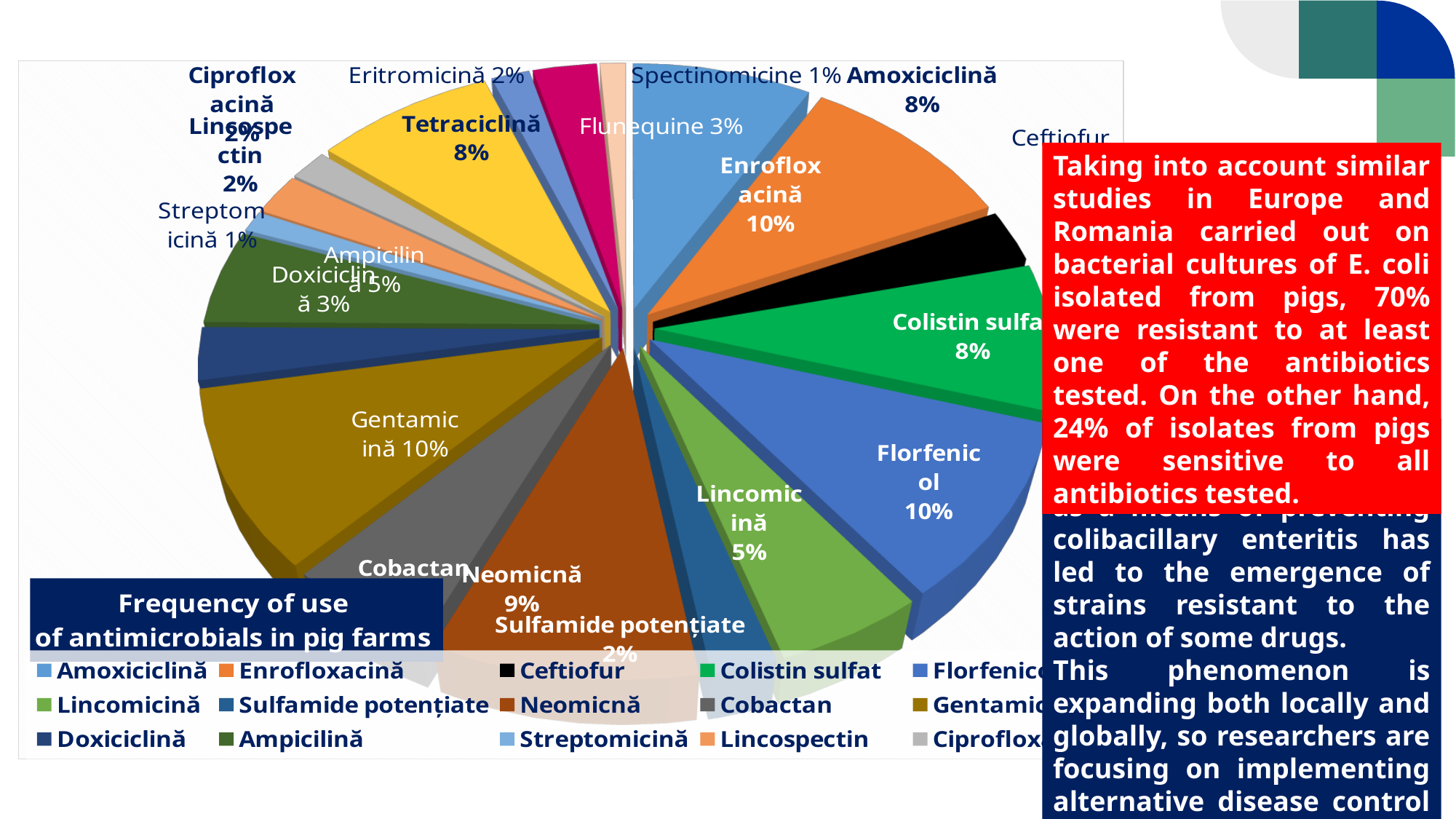
What share of the pie does Streptomicină have? 1% What is the difference in percentage points between Amoxiciclină and Eritromicină? 6 What share of the pie does Neomicnă have? 9% What share of the pie does Tetraciclină have? 8% What is the title of the chart? Frequency of use of antimicrobials in pig farms What share of the pie does Enrofloxacină have? 10% What is the difference in percentage points between Gentamicină and Neomicnă? 1 What share of the pie does Flunequine have? 3% Which has a larger share, Ampicilină or Doxiciclină? Ampicilină What share of the pie does Lincomicină have? 5% Which has a larger share, Florfenicol or Colistin sulfat? Florfenicol What kind of chart is shown on the slide? pie chart